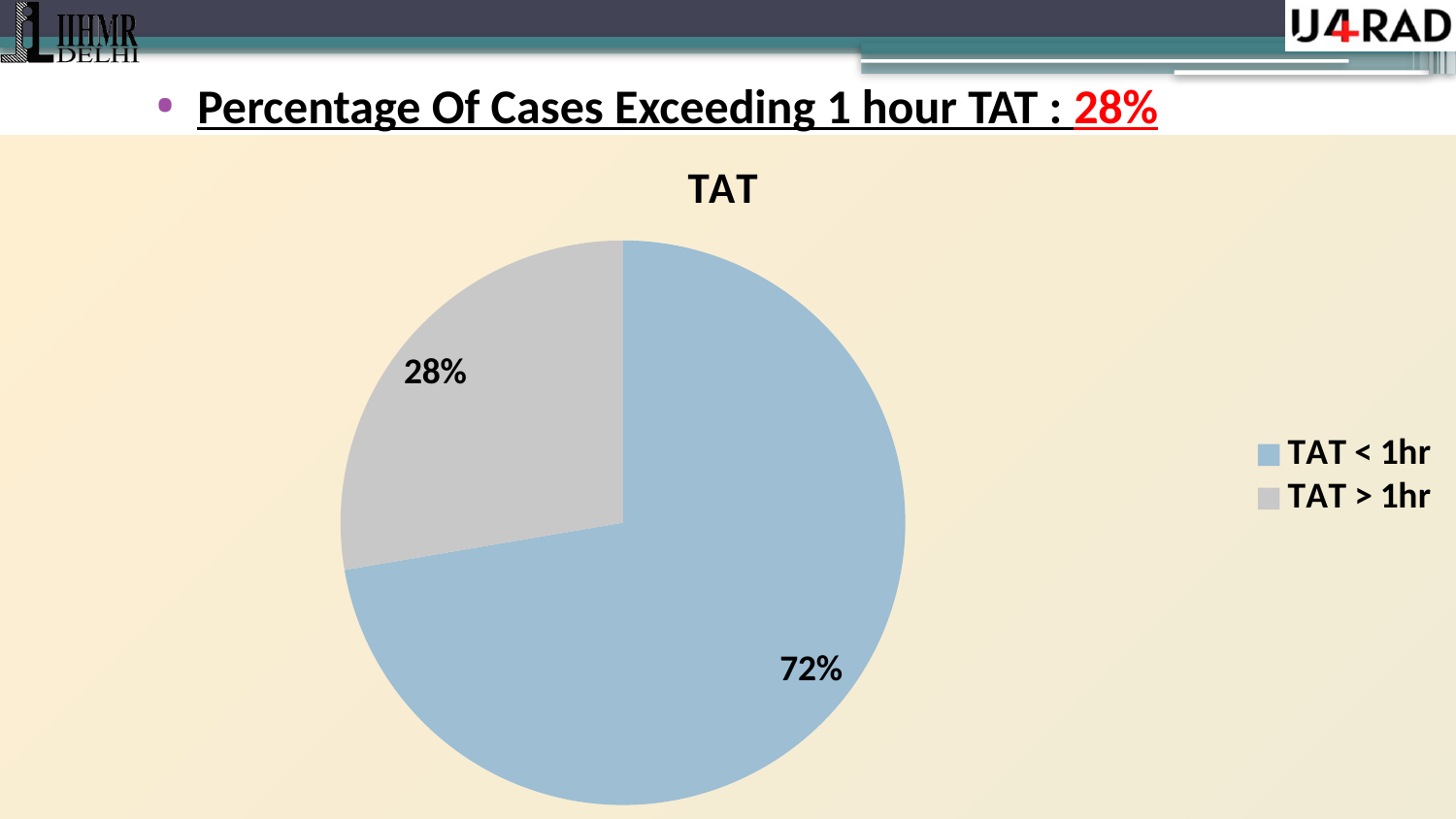
How many entries does the legend list? 2 What colour is the TAT < 1hr slice? blue What is the title of the chart? TAT What percentage of cases have TAT < 1hr? 72% Which is larger, the share for TAT < 1hr or the share for TAT > 1hr? TAT < 1hr What type of chart is shown on the slide? pie chart Which category has the largest share of the pie? TAT < 1hr What share of the pie does the TAT > 1hr slice represent? 28% Which category has the smallest share of the pie? TAT > 1hr What percentage of cases have TAT > 1hr? 28% How many slices does the pie chart have? 2 What is the difference between the TAT < 1hr share and the TAT > 1hr share? 44%